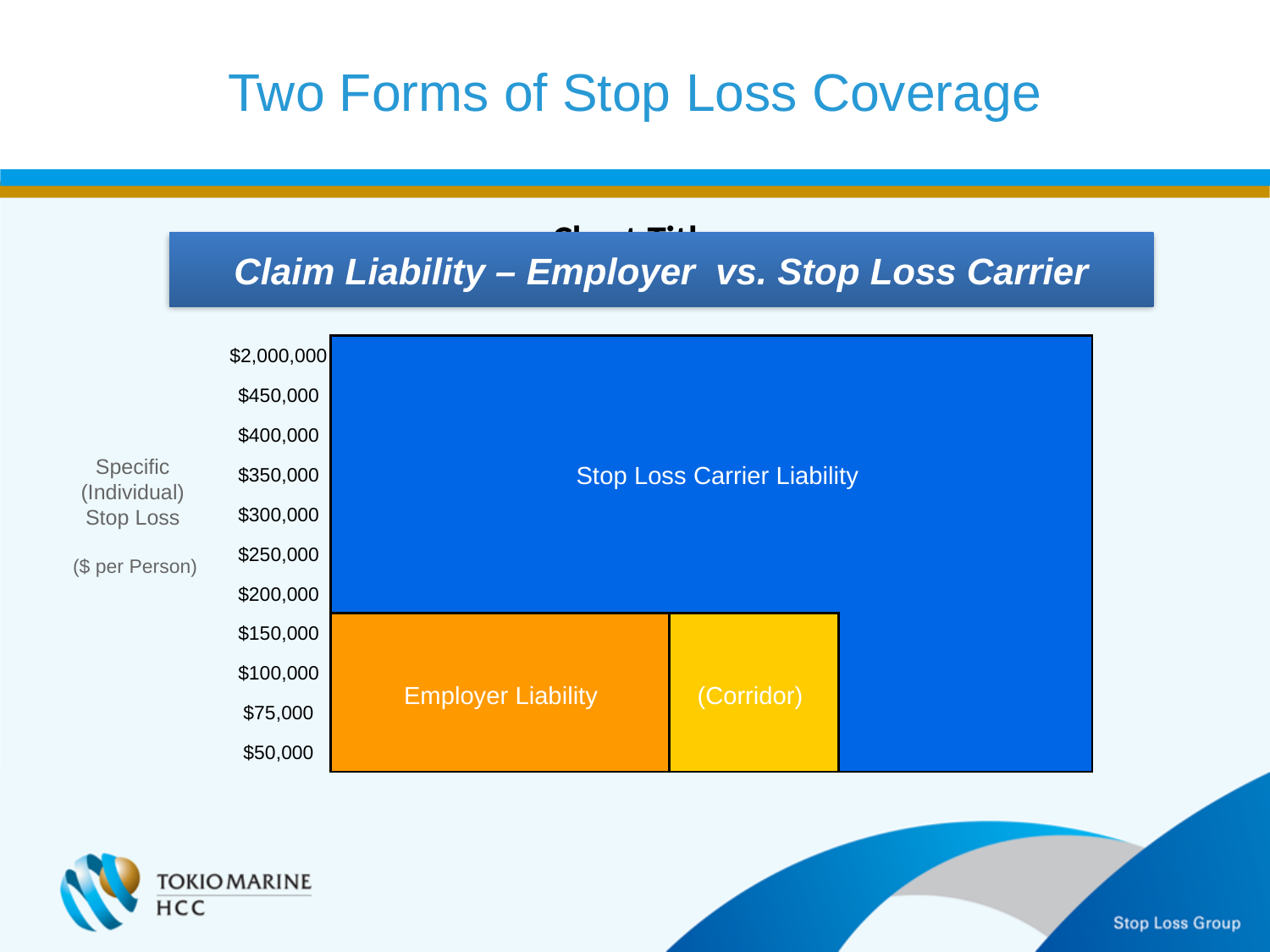
What is the lowest value shown on the chart's vertical axis? $50,000 What is the title of the chart? Claim Liability – Employer vs. Stop Loss Carrier What is the label of the large blue region at the top of the chart? Stop Loss Carrier Liability What unit is given for the vertical axis of the chart? $ per Person How many labelled regions does the chart contain? 3 Is the top of the Employer Liability region above or below $300,000 on the vertical axis? below What is the label of the orange region at the bottom left of the chart? Employer Liability What is the label of the yellow region in the chart? (Corridor) Which region is larger in the chart, Stop Loss Carrier Liability or Employer Liability? Stop Loss Carrier Liability What is the highest value shown on the chart's vertical axis? $2,000,000 What kind of chart is shown on the slide? bar chart